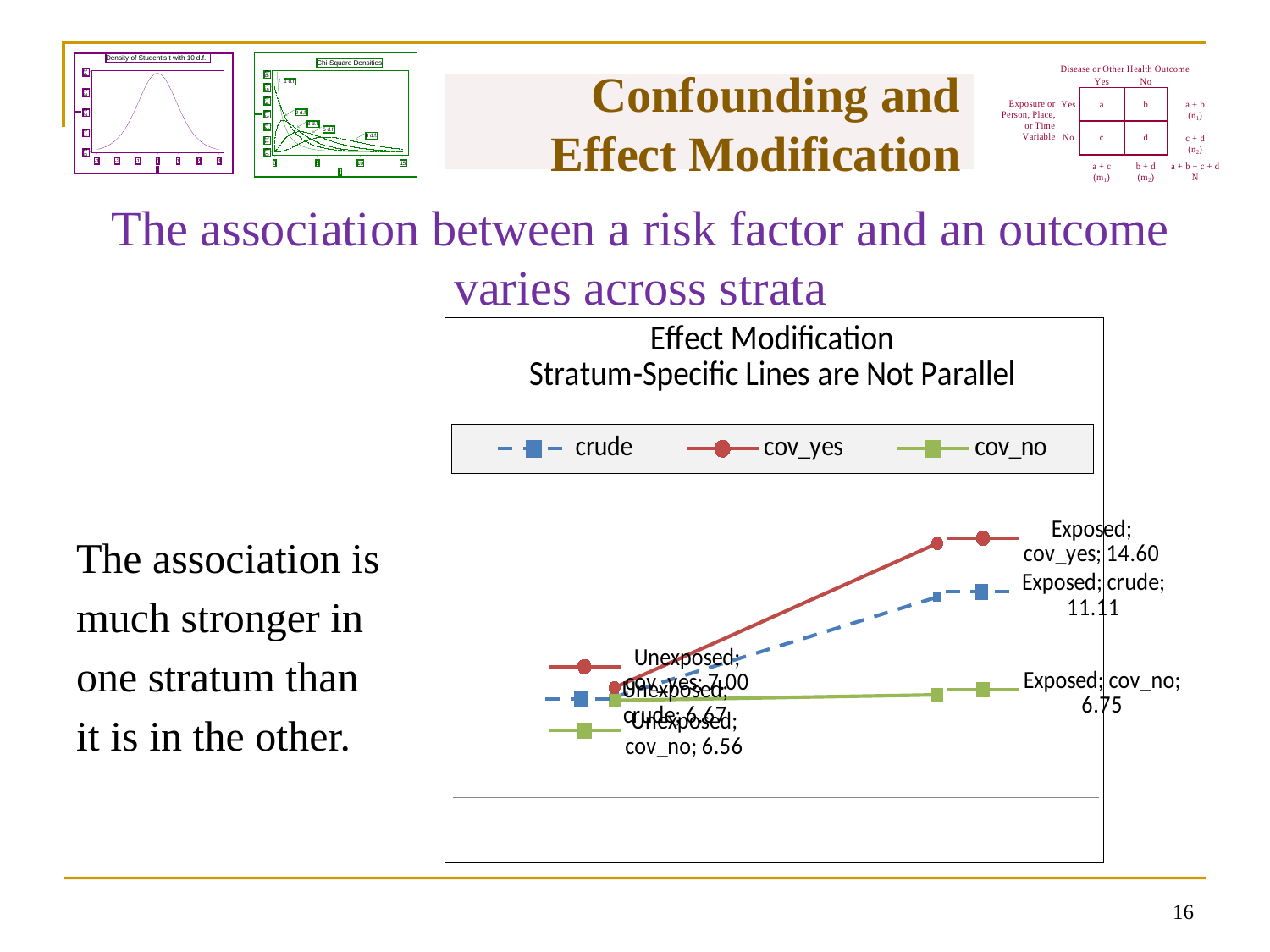
Which series has the highest value in the Exposed group? cov_yes Which series has the lowest value in the Exposed group? cov_no What is the difference between the Exposed values for cov_yes and cov_no? 7.85 What is the value for cov_no in the Exposed group? 6.75 What is the title of the chart? Effect Modification Stratum-Specific Lines are Not Parallel What is the value for cov_yes in the Unexposed group? 7.00 How much does the cov_yes series increase from Unexposed to Exposed? 7.60 What is the value for crude in the Exposed group? 11.11 What kind of chart is shown on the slide? line chart Does the cov_yes line rise or fall from Unexposed to Exposed? rises What is the value for cov_yes in the Exposed group? 14.60 How many series does the chart's legend list? 3